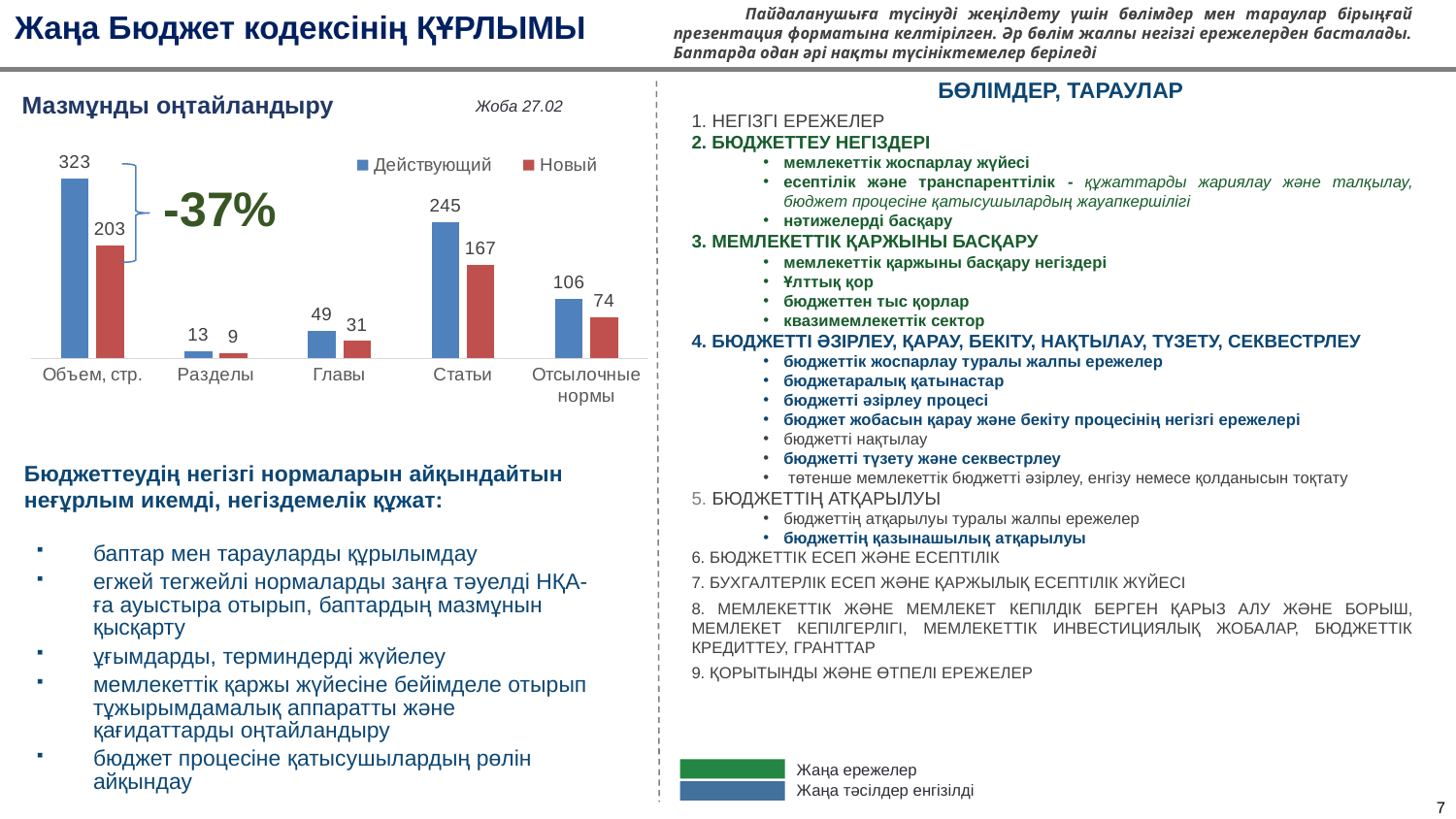
How many categories are shown on the x axis of the chart? 5 What is the value for Новый in the Статьи category? 167 Which is larger in the Отсылочные нормы category: Действующий or Новый? Действующий What percentage change is annotated next to the Объем, стр. bars? -37% Which category has the highest value for the Действующий series? Объем, стр. Which category has the lowest value for the Новый series? Разделы What is the value for Новый in the Отсылочные нормы category? 74 What is the difference between the Действующий and Новый values in the Статьи category? 78 What type of chart is shown on the slide? Bar chart How many series does the chart legend list? 2 What is the value for Действующий in the Главы category? 49 What is the value for Действующий in the Объем, стр. category? 323